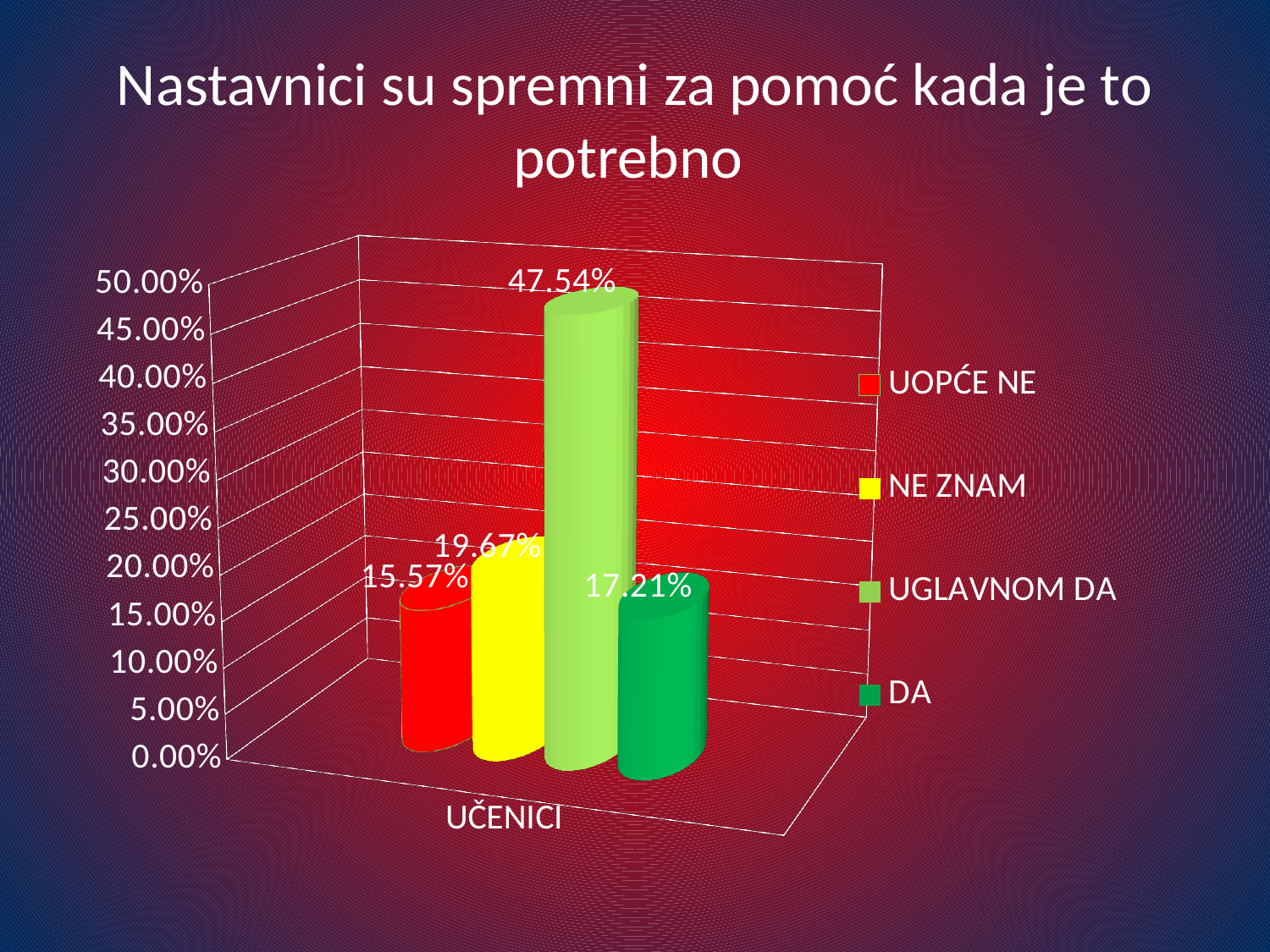
How many series does the legend list? 4 Which is larger, the value for NE ZNAM or the value for DA? NE ZNAM What is the difference between the values for UGLAVNOM DA and NE ZNAM? 27.87% What kind of chart is shown on the slide? Bar chart What is the value for NE ZNAM? 19.67% What is the value for UOPĆE NE? 15.57% Which series has the lowest value? UOPĆE NE Which series has the highest value? UGLAVNOM DA What is the title of the chart? Nastavnici su spremni za pomoć kada je to potrebno What is the difference between the values for DA and UOPĆE NE? 1.64% What is the value for UGLAVNOM DA? 47.54% What is the value for DA? 17.21%